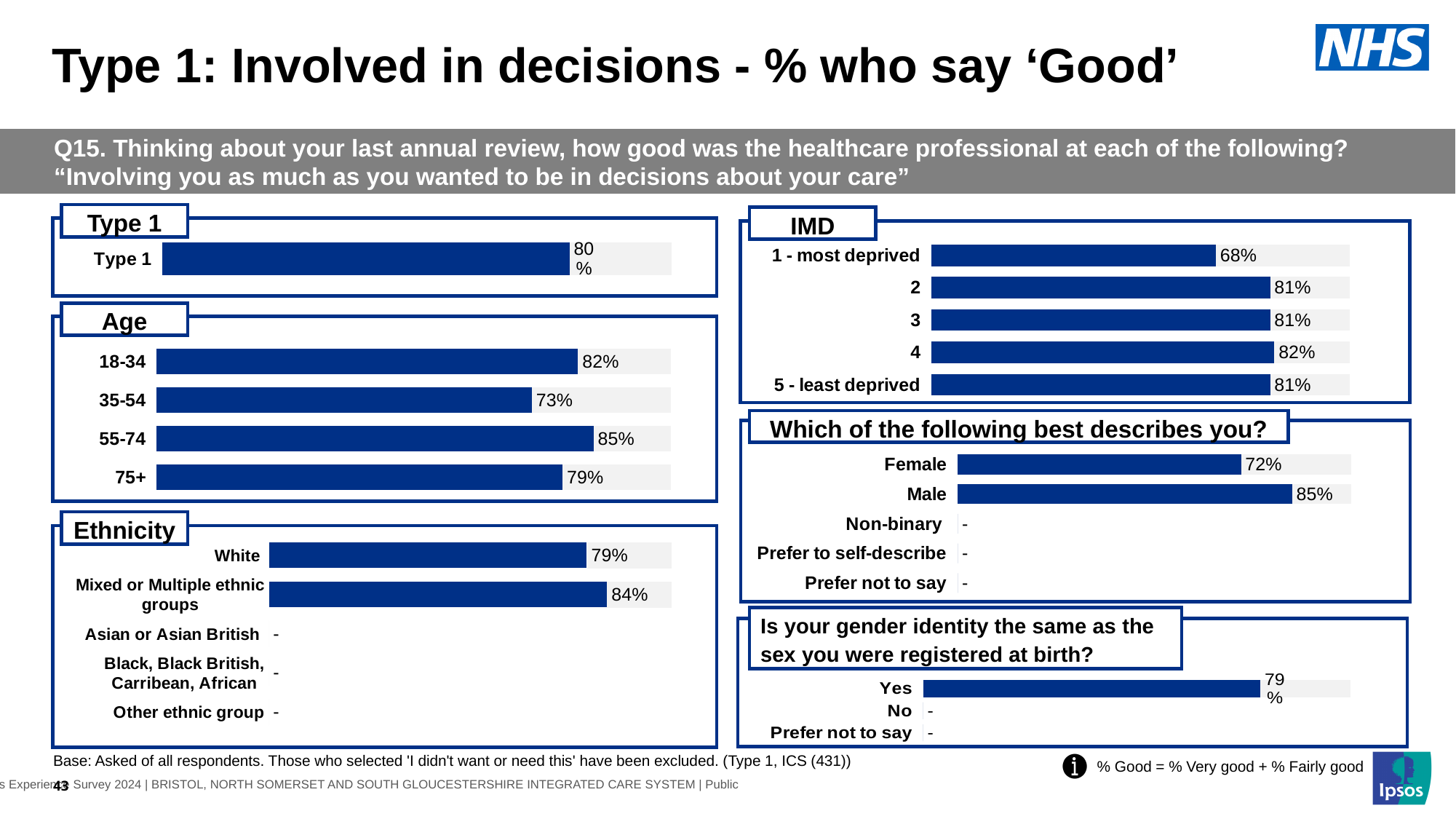
In the Age chart, which age group has the highest value? 55-74 In the IMD chart, which category has the lowest value? 1 - most deprived In the Type 1 chart, what is the value for Type 1? 80% In the 'Is your gender identity the same as the sex you were registered at birth?' chart, what is the value for Yes? 79% In the IMD chart, how many categories are plotted? 5 In the 'Which of the following best describes you?' chart, what is the difference between the values for Male and Female? 13% In the Age chart, what is the value for 35-54? 73% In the IMD chart, what is the value for 1 - most deprived? 68% In the Ethnicity chart, which is larger, the value for White or the value for Mixed or Multiple ethnic groups? Mixed or Multiple ethnic groups In the Ethnicity chart, what is the value for Mixed or Multiple ethnic groups? 84% In the Age chart, what is the difference between the values for 18-34 and 75+? 3% In the Age chart, which age group has the lowest value? 35-54